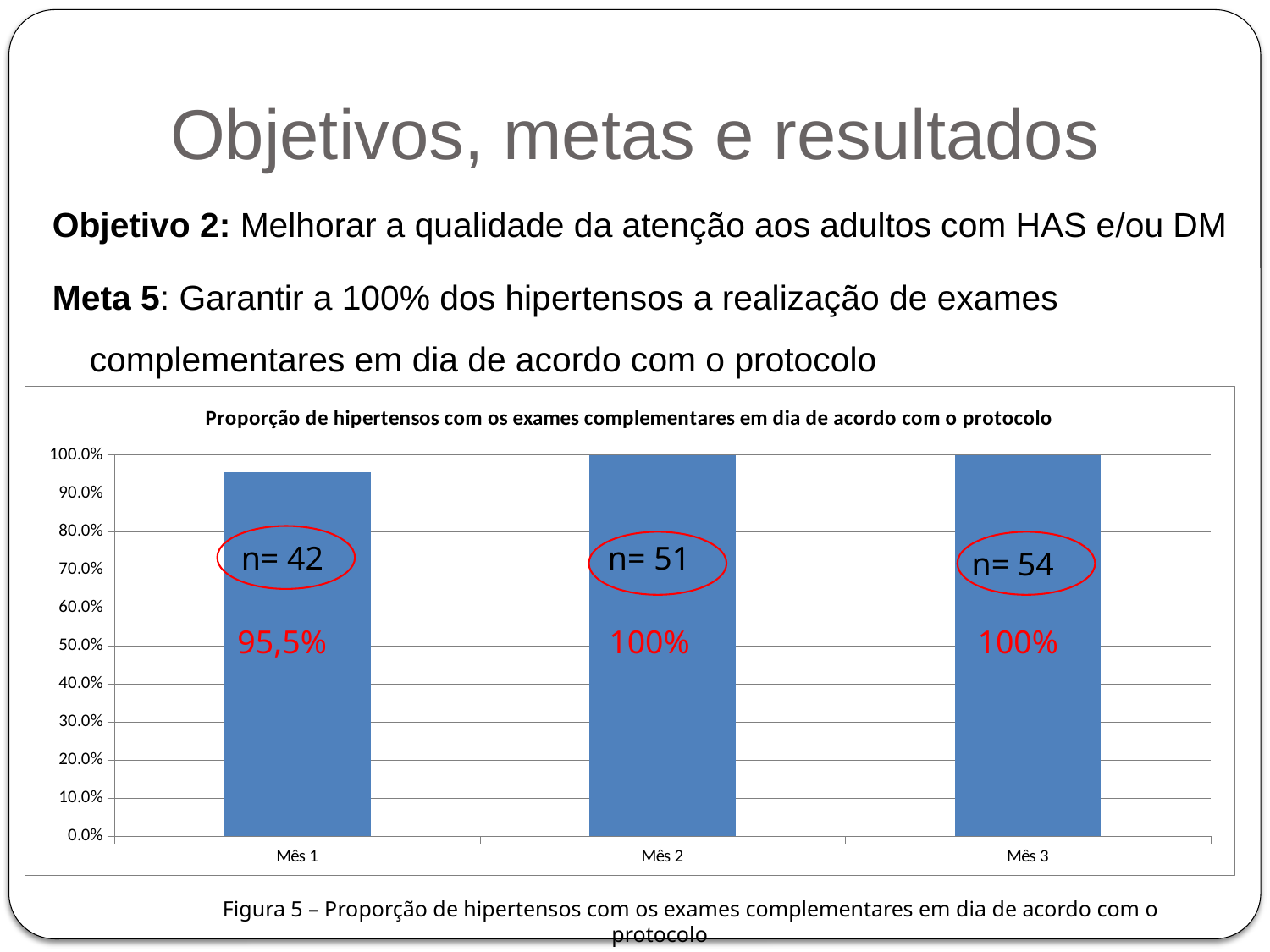
What is the n value shown for Mês 1? n= 42 How many months are shown on the x axis? 3 What is the n value shown for Mês 3? n= 54 What is the value for Mês 2? 100% Which is larger, the value for Mês 1 or the value for Mês 2? Mês 2 What is the title of the chart? Proporção de hipertensos com os exames complementares em dia de acordo com o protocolo Do the values rise or fall from Mês 1 to Mês 2? Rise What is the value for Mês 3? 100% What is the value for Mês 1? 95,5% Is the value for Mês 1 greater or less than 90.0%? greater What kind of chart is shown? Bar chart Which month has the lowest proportion? Mês 1